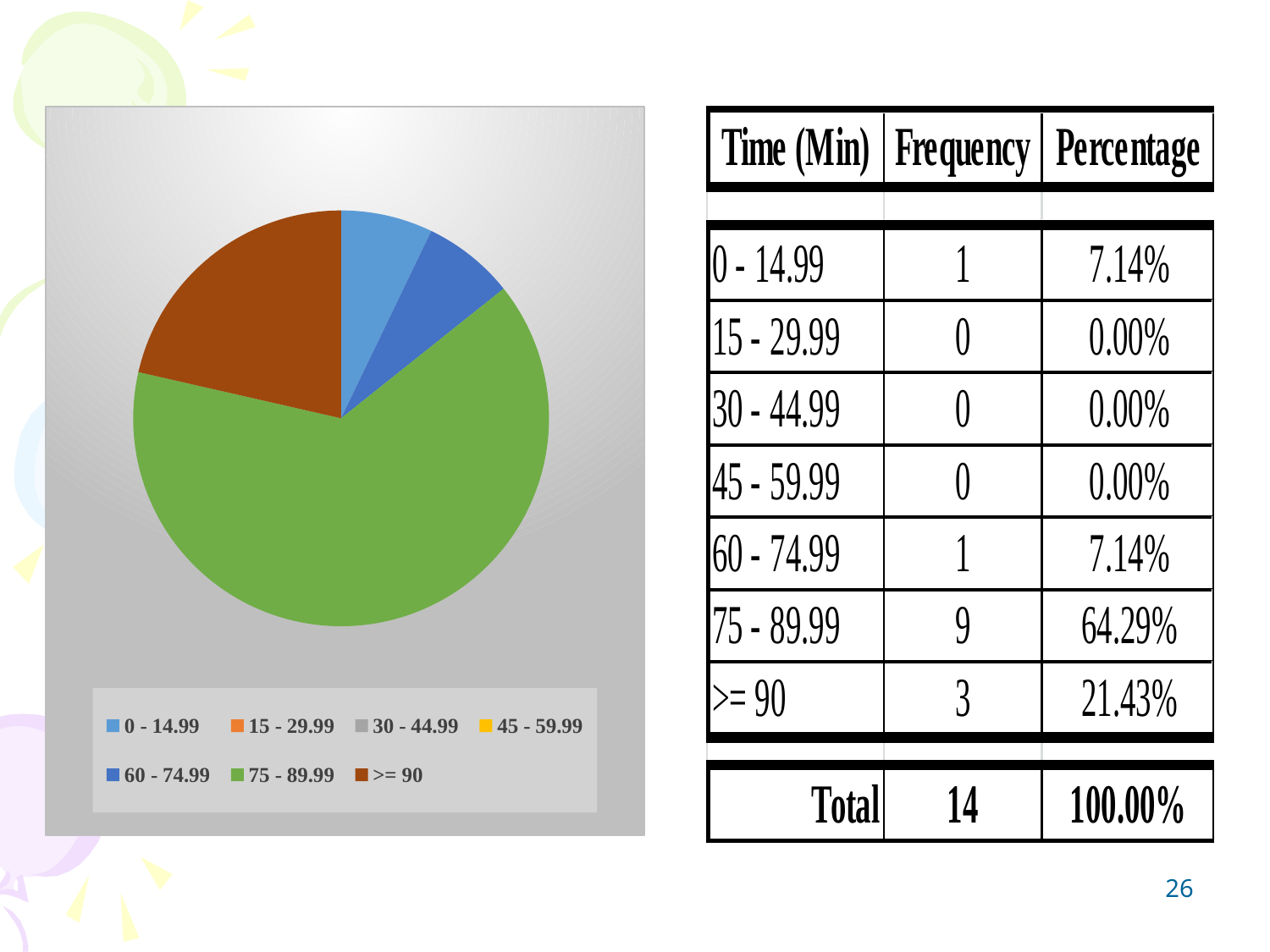
What share of the pie does the 75 - 89.99 category represent, according to the table? 64.29% What kind of chart is shown on the left of the slide? pie chart What colour is the largest slice of the pie chart? green What share of the pie does the >= 90 category represent, according to the table? 21.43% How many categories in the table have a frequency of 0? 3 Which slice is larger in the pie chart, 0 - 14.99 or 75 - 89.99? 75 - 89.99 Which slice is larger in the pie chart, >= 90 or 60 - 74.99? >= 90 Which category has the largest slice of the pie chart? 75 - 89.99 What is the frequency for the 75 - 89.99 category in the table? 9 What is the difference in frequency between the 75 - 89.99 and >= 90 categories? 6 What is the total frequency shown in the table? 14 How many categories does the pie chart's legend list? 7